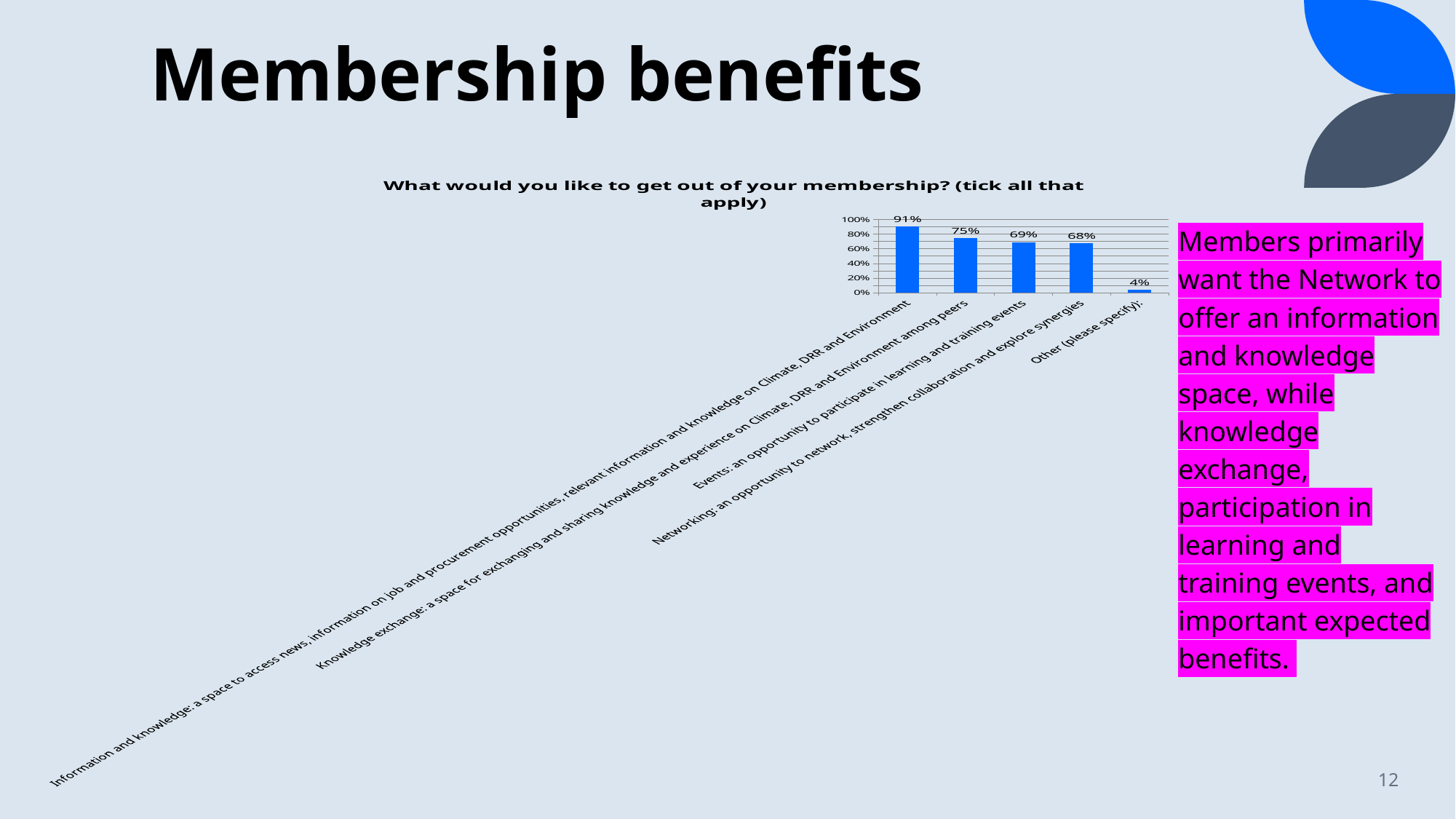
Which category has the lowest value? Other (please specify) How many categories are plotted in the chart? 5 What is the value for the 'Knowledge exchange' category? 75% What is the value for the 'Networking' category? 68% What is the title of the chart? What would you like to get out of your membership? (tick all that apply) What is the difference between the 'Information and knowledge' value and the 'Knowledge exchange' value? 16% What is the value for 'Other (please specify)'? 4% Which is larger, the value for 'Knowledge exchange' or the value for 'Events'? Knowledge exchange What is the value for the 'Events' category? 69% Which category has the highest value? Information and knowledge What kind of chart is shown on the slide? bar chart What is the value for the 'Information and knowledge' category? 91%